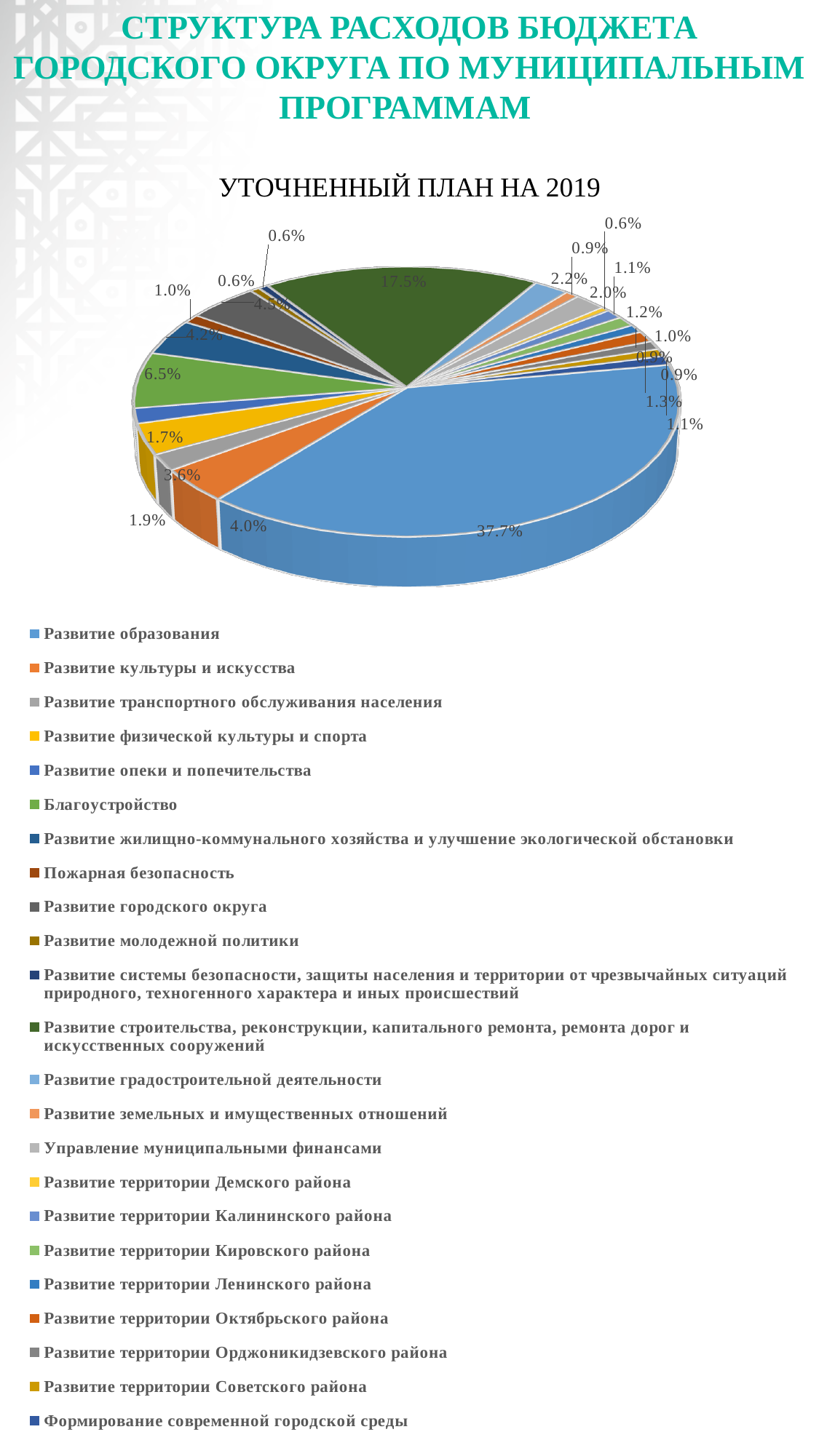
By how many percentage points does the share of Развитие образования exceed that of Развитие строительства, реконструкции, капитального ремонта, ремонта дорог и искусственных сооружений? 20.2 What share of the budget expenditures is shown for Развитие образования? 37.7% Which program has the largest share of the budget expenditures in the pie chart? Развитие образования What share is shown for Благоустройство? 6.5% How many programs are listed in the legend of the pie chart? 23 Which has a larger share: Развитие образования or Развитие строительства, реконструкции, капитального ремонта, ремонта дорог и искусственных сооружений? Развитие образования What share is shown for Развитие транспортного обслуживания населения? 1.9% What kind of chart is shown on the slide? pie chart What is the title shown above the pie chart? УТОЧНЕННЫЙ ПЛАН НА 2019